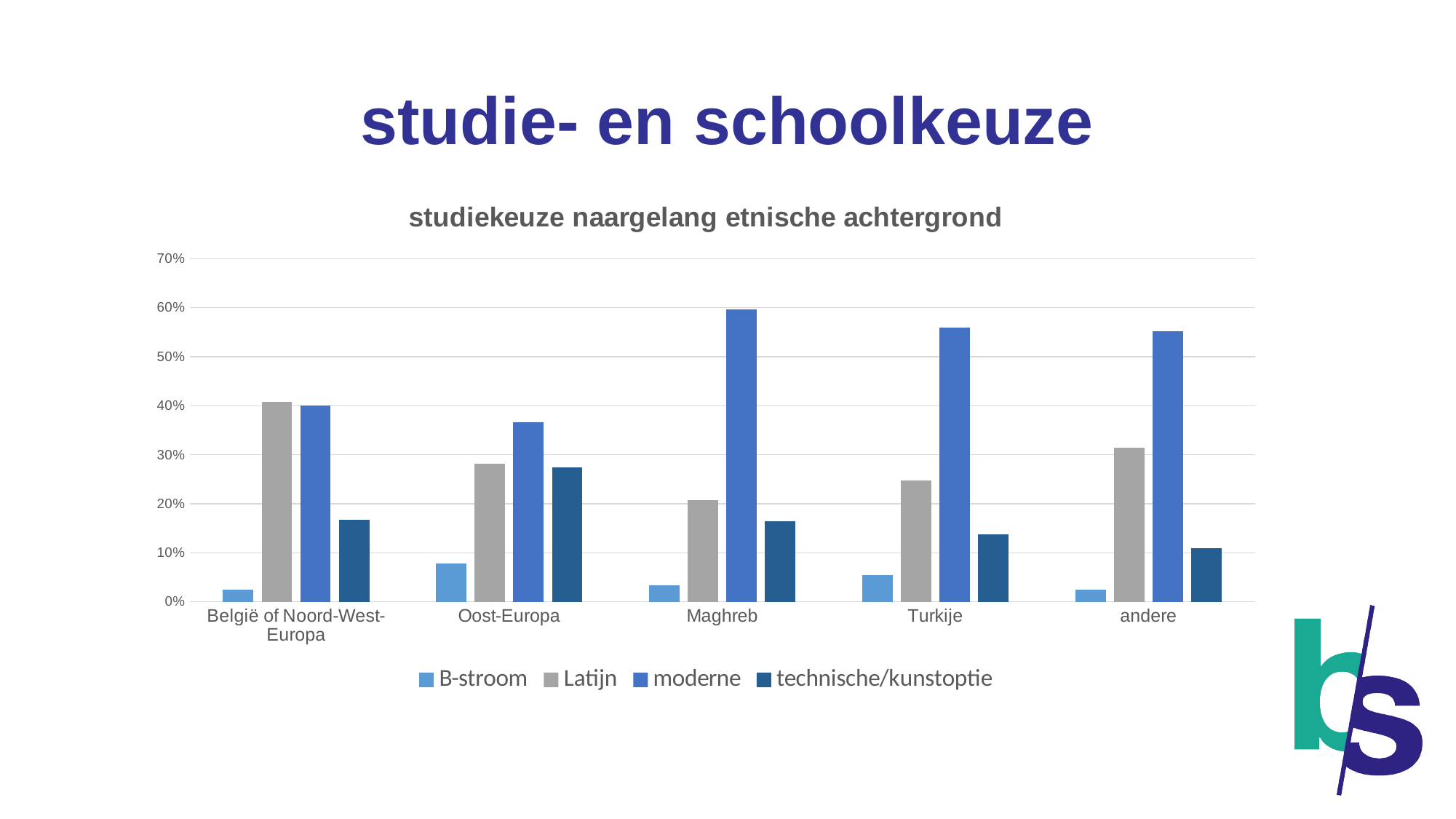
Which category has the lowest value for technische/kunstoptie? andere What is the title of the chart? studiekeuze naargelang etnische achtergrond Is the value for Latijn in Oost-Europa greater or less than 30%? less In Turkije, which is larger: Latijn or technische/kunstoptie? Latijn What kind of chart is shown on the slide? bar chart How many series does the legend list? 4 Is the value for moderne in Maghreb greater or less than 50%? greater Which category has the highest value for B-stroom? Oost-Europa Which category has the highest value for Latijn? België of Noord-West-Europa Is the value for technische/kunstoptie in Oost-Europa greater or less than 20%? greater Which category has the highest value for moderne? Maghreb How many ethnic background categories are shown on the x axis? 5